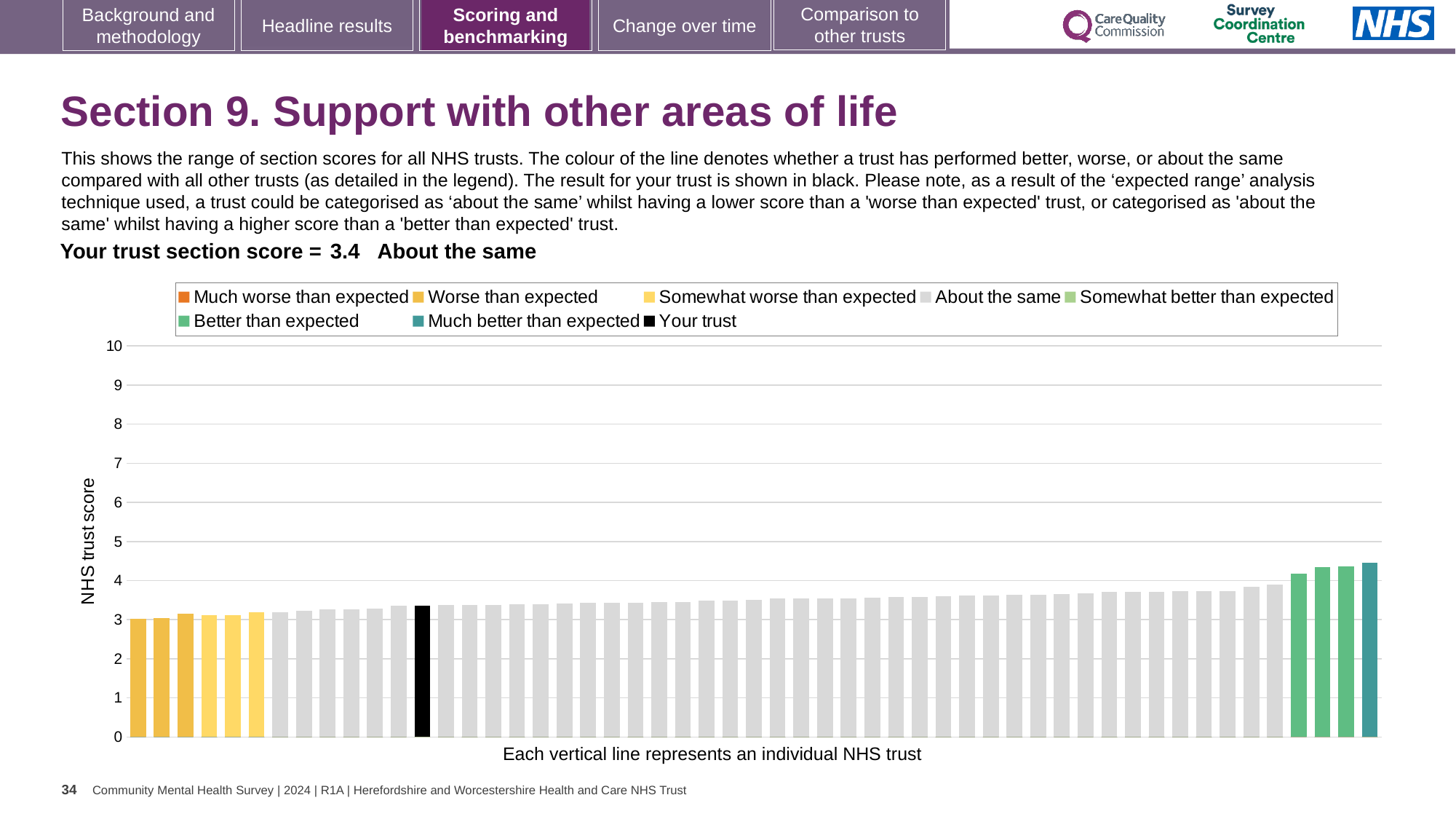
Is the value for your trust greater or less than 5? less What is the section score for your trust shown on the chart? 3.4 Is the value of the highest bar greater or less than 4? greater Is the value for your trust greater or less than 3? greater How many entries does the chart legend list? 8 What is the label on the vertical axis of the chart? NHS trust score Do the bar values rise or fall from left to right along the x axis? rise Which legend category does the lowest bar on the chart belong to? Worse than expected What kind of chart is shown on the slide? bar chart Which legend category does the highest bar on the chart belong to? Much better than expected What colour is the bar representing your trust? black